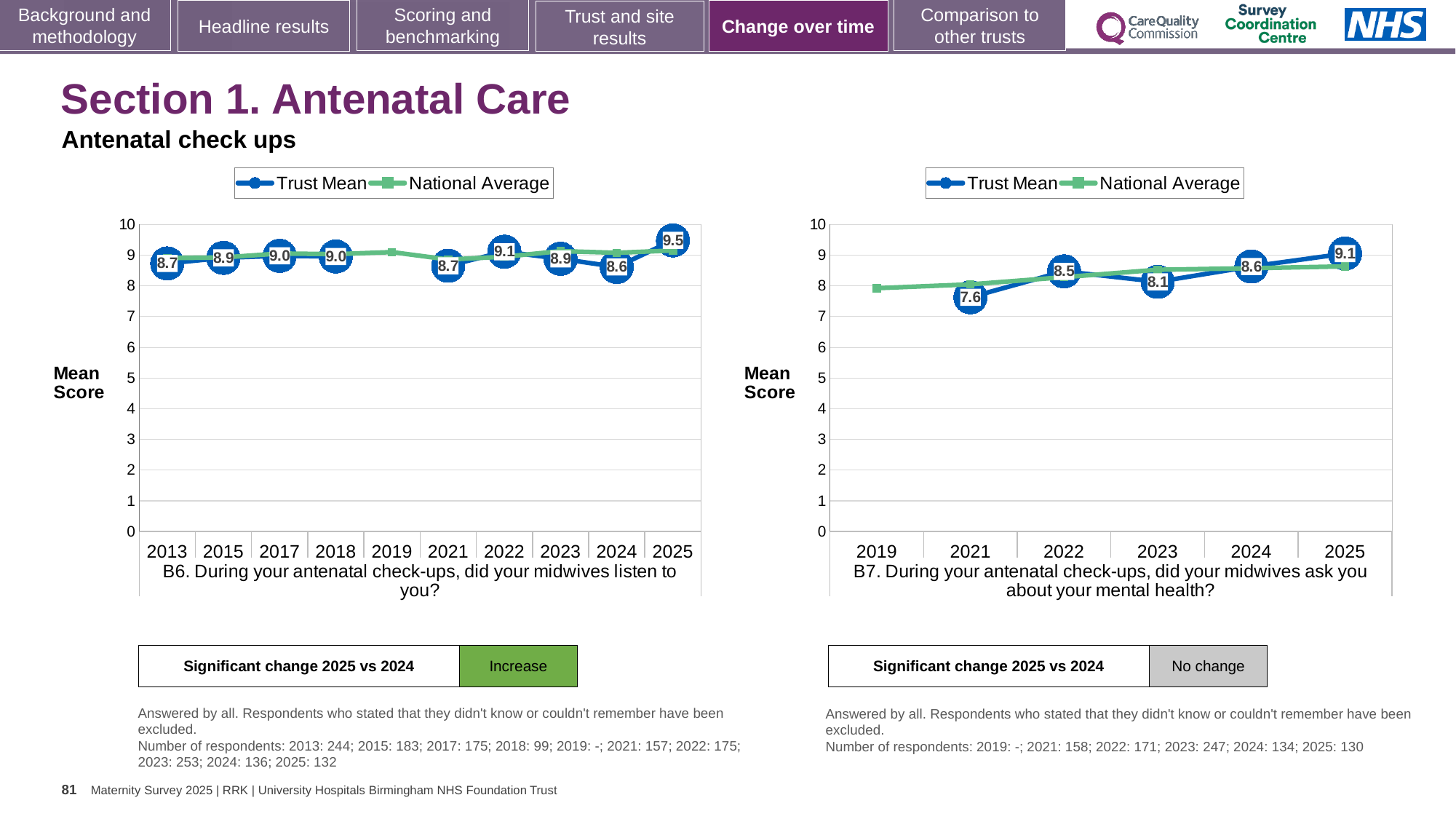
In the B6 chart (left), what is the Trust Mean for 2013? 8.7 In the B7 chart (right), is the National Average for 2019 greater or less than 7? greater In the B7 chart (right), what is the difference between the Trust Mean for 2025 and 2021? 1.5 What type of chart is the B6 chart (left)? Line chart In the B6 chart (left), what is the difference between the Trust Mean for 2025 and 2024? 0.9 In the B6 chart (left), what is the Trust Mean for 2025? 9.5 In the B7 chart (right), which year has the highest Trust Mean? 2025 In the B6 chart (left), which year has the lowest labelled Trust Mean? 2024 How many series does the legend of the B7 chart (right) list? 2 In the B7 chart (right), is the Trust Mean higher in 2022 or 2023? 2022 How many years are shown on the x axis of the B6 chart (left)? 10 In the B7 chart (right), what is the Trust Mean for 2021? 7.6